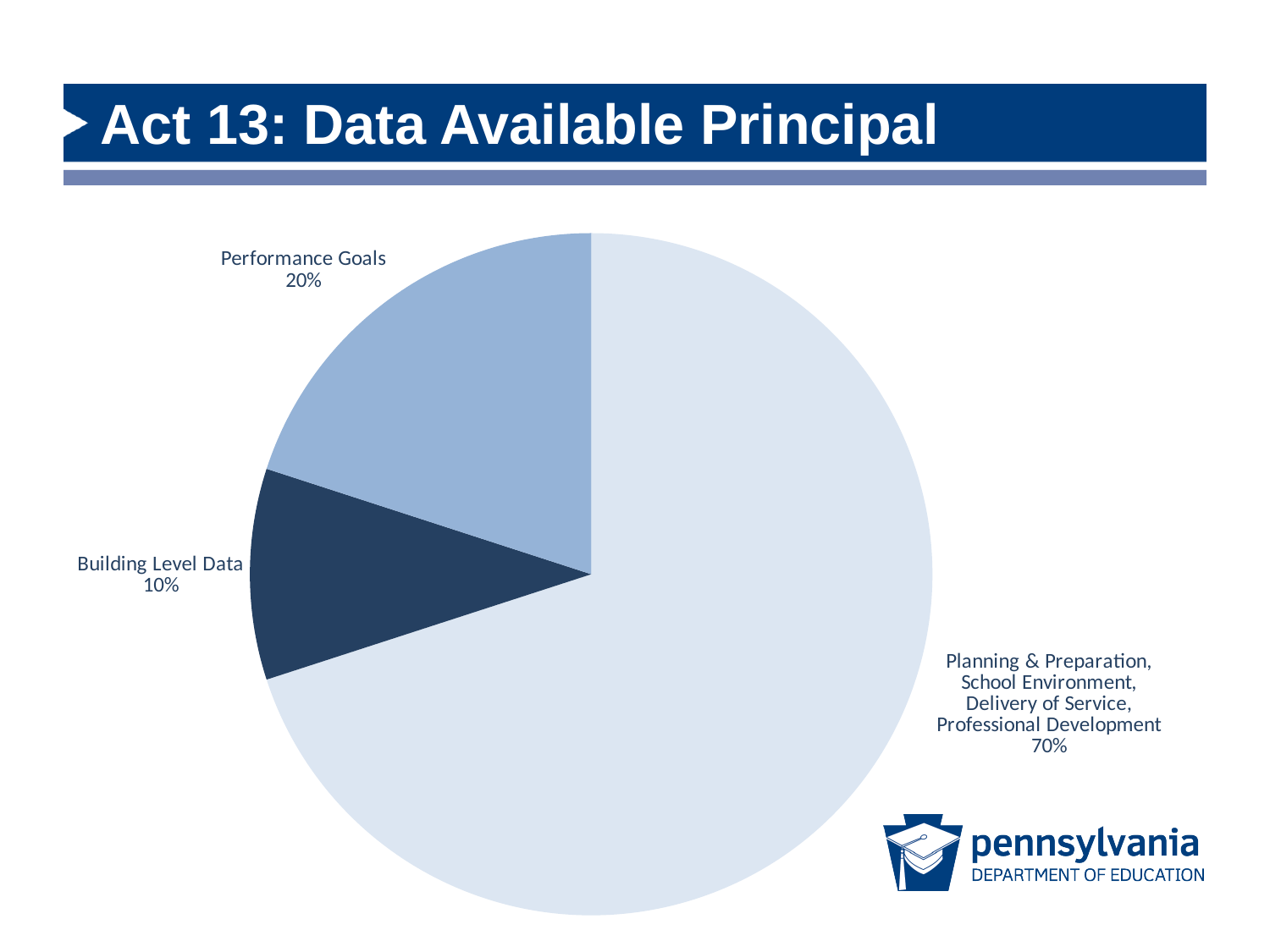
Which is larger, Performance Goals or Building Level Data? Performance Goals Which slice of the pie is the largest? Planning & Preparation, School Environment, Delivery of Service, Professional Development How many slices does the pie chart have? 3 Which slice of the pie is the smallest? Building Level Data What kind of chart is shown on the slide? Pie chart Which slice of the pie is shown in the darkest blue colour? Building Level Data What is the title of the slide containing the pie chart? Act 13: Data Available Principal What share of the pie does Building Level Data represent? 10% What share of the pie does Performance Goals represent? 20% What is the difference in percentage points between the largest slice and Performance Goals? 50% What is the difference in percentage points between Performance Goals and Building Level Data? 10% What share of the pie does the Planning & Preparation, School Environment, Delivery of Service, Professional Development slice represent? 70%